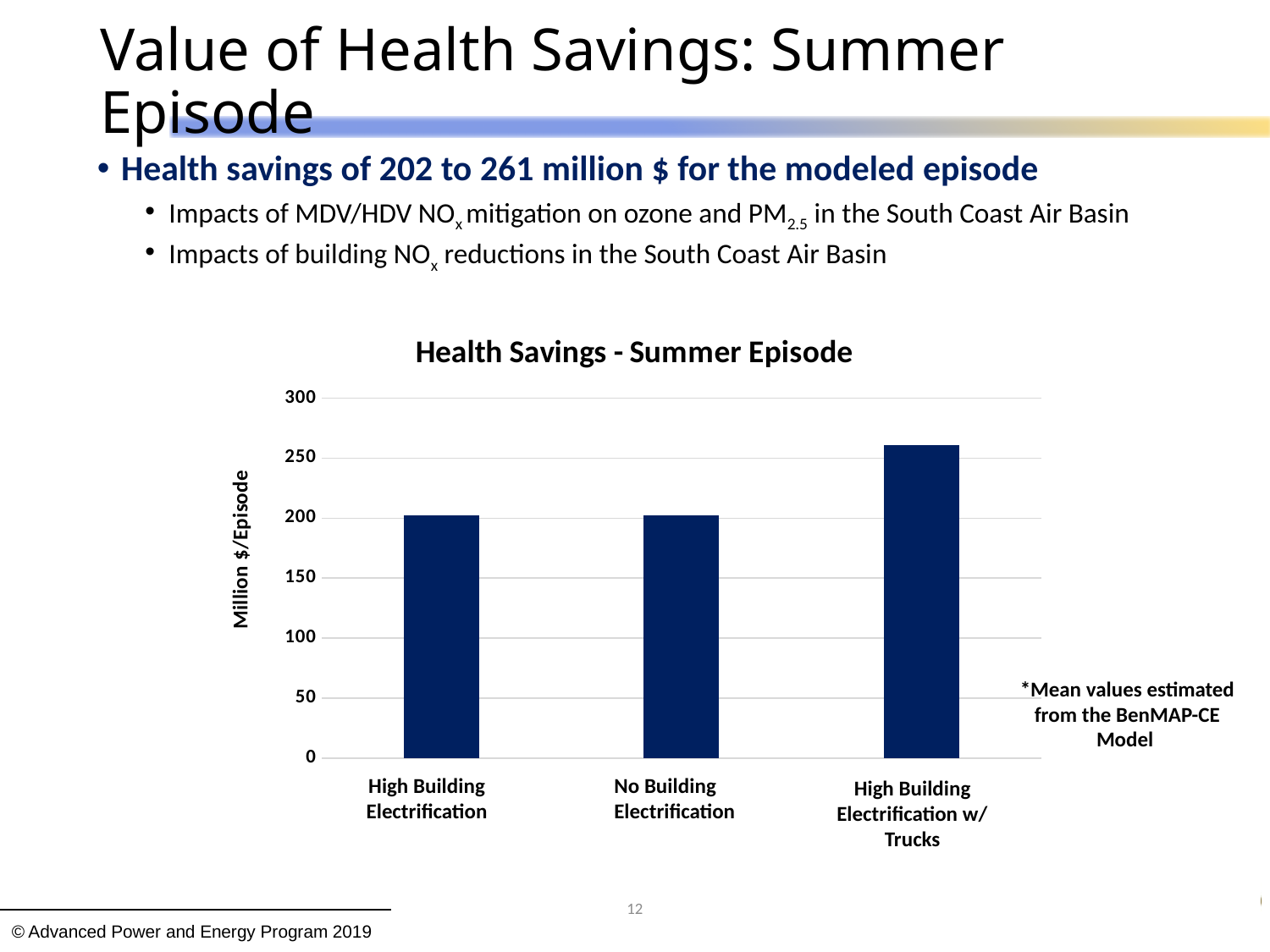
What is the label on the vertical axis of the chart? Million $/Episode Which is larger, the value for No Building Electrification or the value for High Building Electrification w/ Trucks? High Building Electrification w/ Trucks Which category has the highest value in the chart? High Building Electrification w/ Trucks Is the value for High Building Electrification w/ Trucks greater or less than 300? less How many categories are plotted in the chart? 3 Is the value for High Building Electrification greater or less than 250? less What is the title of the chart? Health Savings - Summer Episode Is the value for No Building Electrification greater or less than 150? greater Which is larger, the value for High Building Electrification or the value for High Building Electrification w/ Trucks? High Building Electrification w/ Trucks What type of chart is shown on the slide? bar chart